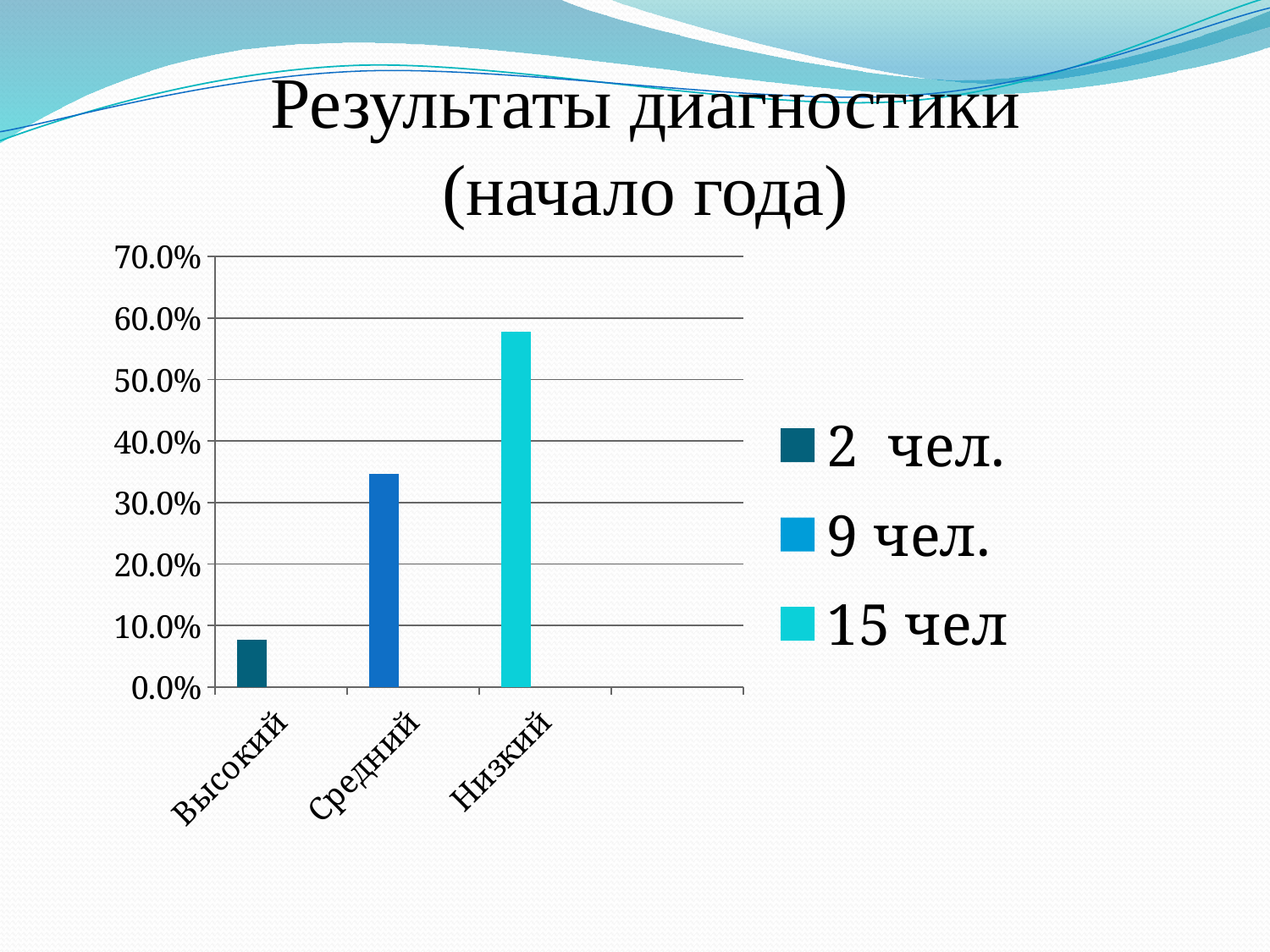
How many categories are shown on the x axis of the chart? 3 How many entries does the chart's legend list? 3 What kind of chart is shown on the slide? bar chart Which category has the highest bar in the chart? Низкий What is the title of the chart slide? Результаты диагностики (начало года) Do the bar values rise or fall moving from Высокий to Низкий along the x axis? rise Is the value for Средний greater or less than 30.0%? greater Is the value for Высокий greater or less than 10.0%? less Is the value for Средний greater or less than 40.0%? less Which category has the lowest bar in the chart? Высокий Which is larger, the value for Средний or the value for Высокий? Средний